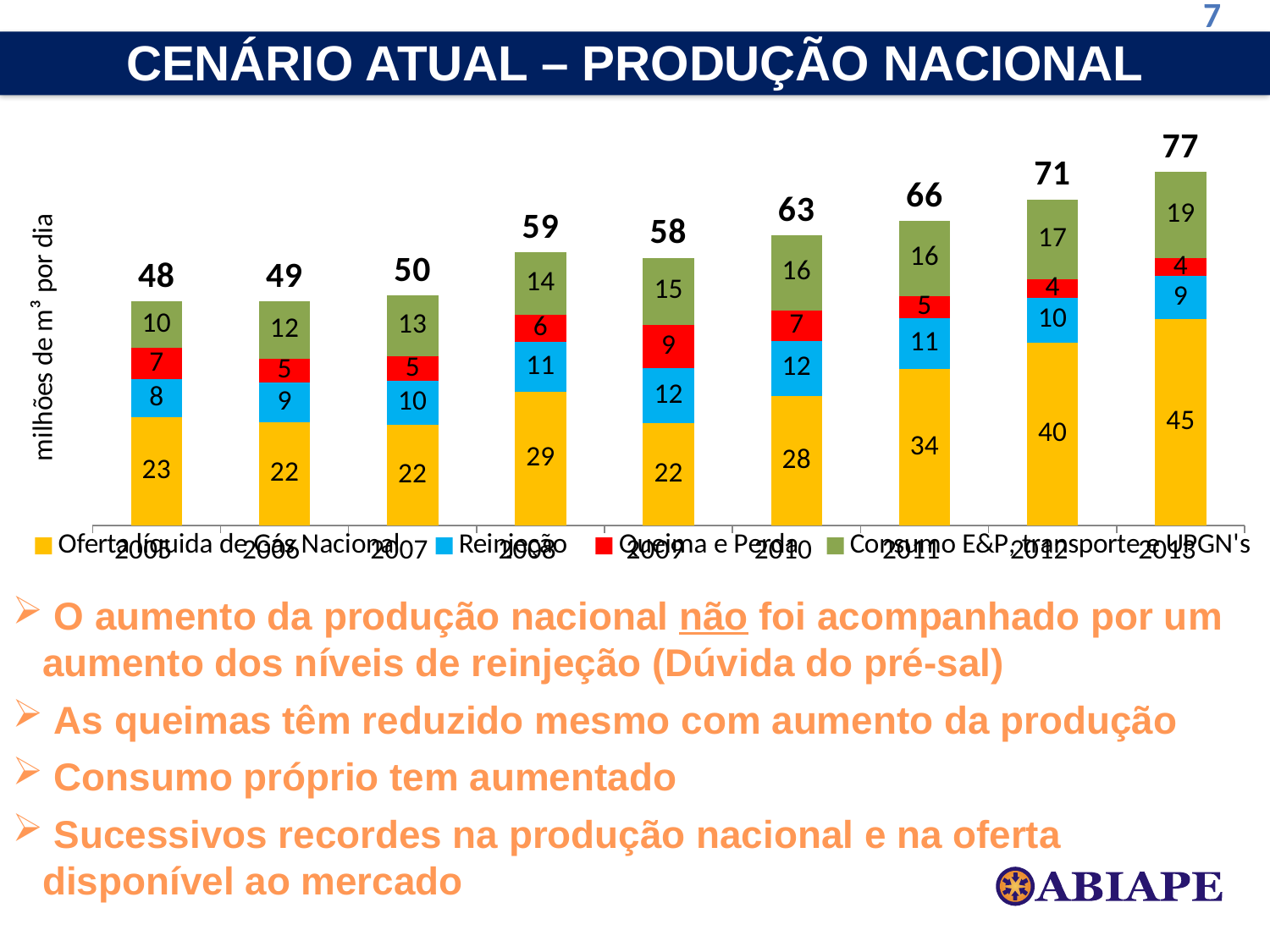
What is the total value printed above the bar for 2005? 48 What unit is shown on the y axis label? milhões de m³ por dia What is the value of Oferta líquida de Gás Nacional in 2012? 40 What type of chart is shown on the slide? Stacked bar chart What is the value of Queima e Perda in 2013? 4 How many series does the legend list? 4 What is the total value printed above the bar for 2013? 77 Which year has the highest total? 2013 How many years (bars) are shown on the x axis? 9 What is the difference between the total for 2013 and the total for 2005? 29 Which year has the lowest total? 2005 What is the value of Reinjeção in 2009? 12